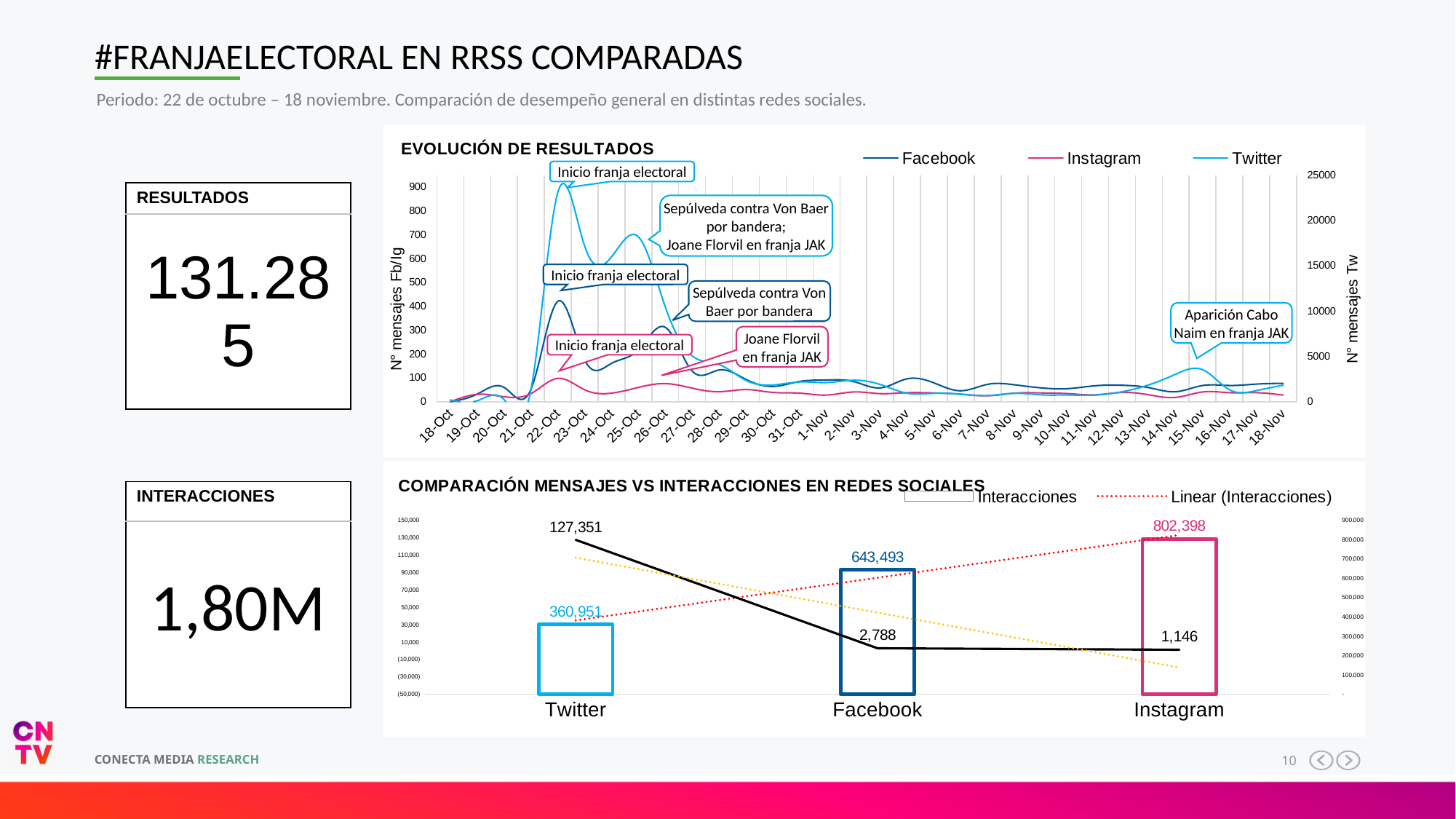
How many networks are shown on the x axis of the 'COMPARACIÓN MENSAJES VS INTERACCIONES EN REDES SOCIALES' chart? 3 In the 'COMPARACIÓN MENSAJES VS INTERACCIONES EN REDES SOCIALES' chart, what is the messages value labelled for Twitter on the black line? 127,351 Which series are listed in the legend of the 'EVOLUCIÓN DE RESULTADOS' chart? Facebook, Instagram, Twitter In the 'COMPARACIÓN MENSAJES VS INTERACCIONES EN REDES SOCIALES' chart, what is the difference between the Interacciones values for Instagram and Twitter? 441,447 What kind of chart is the 'EVOLUCIÓN DE RESULTADOS' chart? Line chart In the 'COMPARACIÓN MENSAJES VS INTERACCIONES EN REDES SOCIALES' chart, which network has the lowest Interacciones value? Twitter In the 'COMPARACIÓN MENSAJES VS INTERACCIONES EN REDES SOCIALES' chart, what is the Interacciones value for Instagram? 802,398 In the 'EVOLUCIÓN DE RESULTADOS' chart, is the Twitter value on 22-Oct greater or less than 20000 on the right axis? greater In the 'COMPARACIÓN MENSAJES VS INTERACCIONES EN REDES SOCIALES' chart, what is the Interacciones value for Twitter? 360,951 In the 'COMPARACIÓN MENSAJES VS INTERACCIONES EN REDES SOCIALES' chart, what is the Interacciones value for Facebook? 643,493 How many series does the legend of the 'EVOLUCIÓN DE RESULTADOS' chart list? 3 In the 'COMPARACIÓN MENSAJES VS INTERACCIONES EN REDES SOCIALES' chart, which network has the highest Interacciones value? Instagram